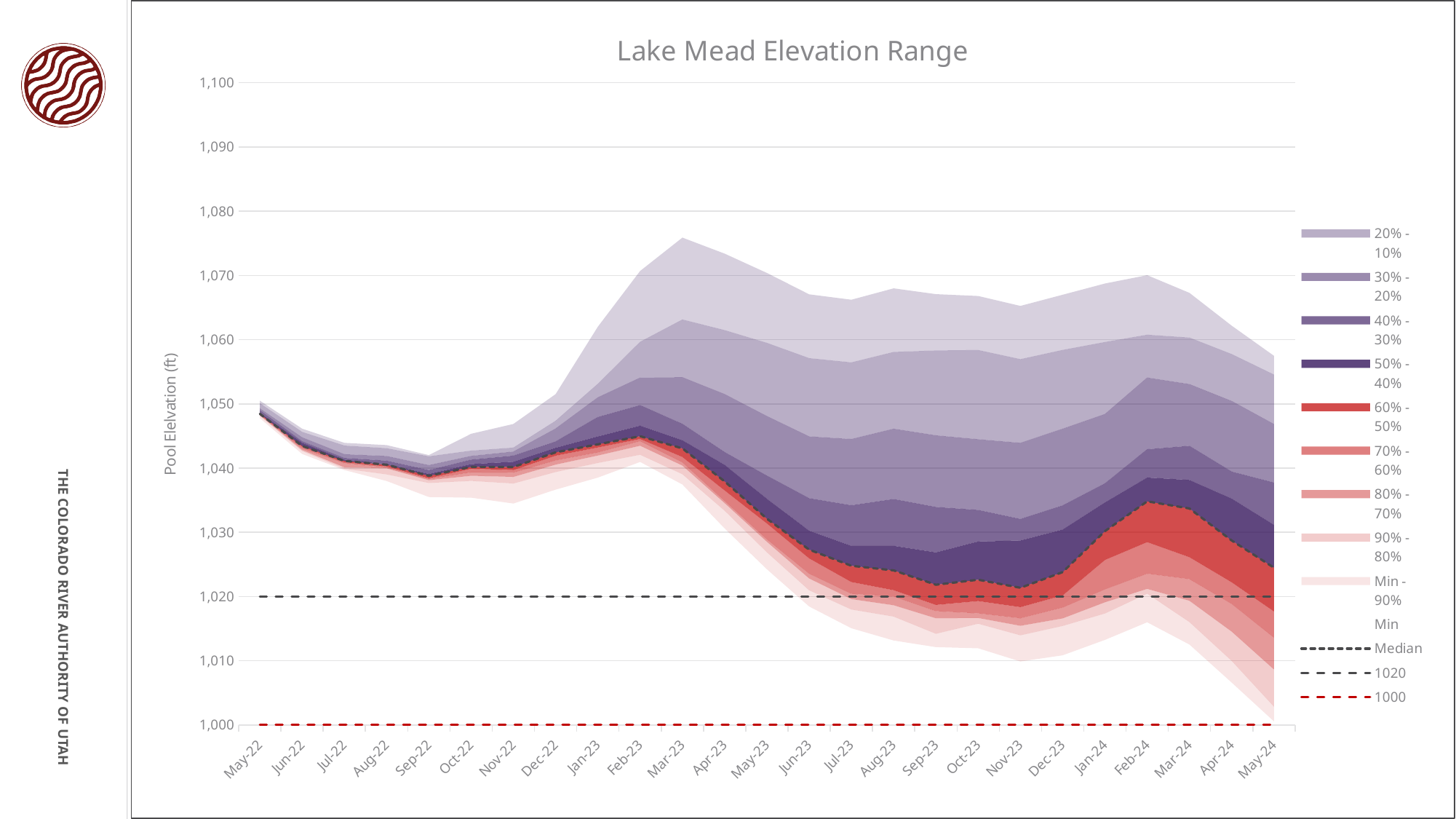
Is the Median value for May-24 greater or less than 1,030? less What is the label on the y axis of the chart? Pool Elelvation (ft) What kind of chart is shown on the slide? area chart At what elevation is the grey dashed reference line drawn? 1,020 Is the Median value for Feb-23 greater or less than 1,040? greater How many months are shown along the x axis of the chart? 25 How many entries does the chart's legend list? 13 At what elevation is the red dashed reference line drawn? 1,000 Is the Median value for Jul-23 greater or less than 1,020? greater Does the Median line rise or fall from Feb-23 to Sep-23? fall Which month has the larger Median value, Feb-23 or Sep-23? Feb-23 What is the title of the chart? Lake Mead Elevation Range